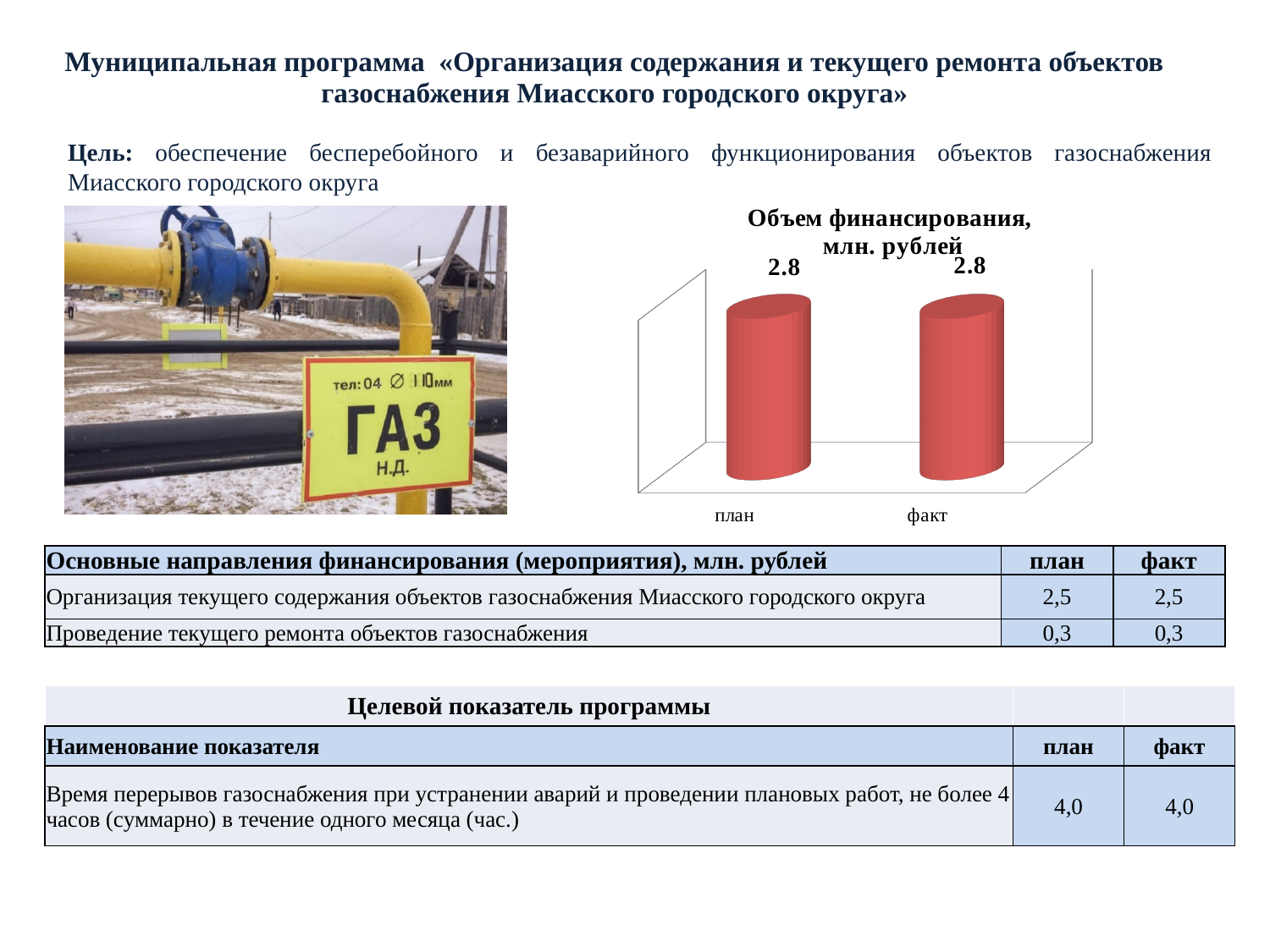
Are the план and факт values in the chart equal? Yes What kind of chart is shown on the slide? Bar chart What is the value for факт in the chart? 2.8 What is the title of the chart? Объем финансирования, млн. рублей What are the category labels on the x axis of the chart? план, факт How many categories are plotted in the chart? 2 What is the difference between the план and факт values in the chart? 0 Do the values change from план to факт in the chart? No, they stay the same What is the value for план in the chart? 2.8